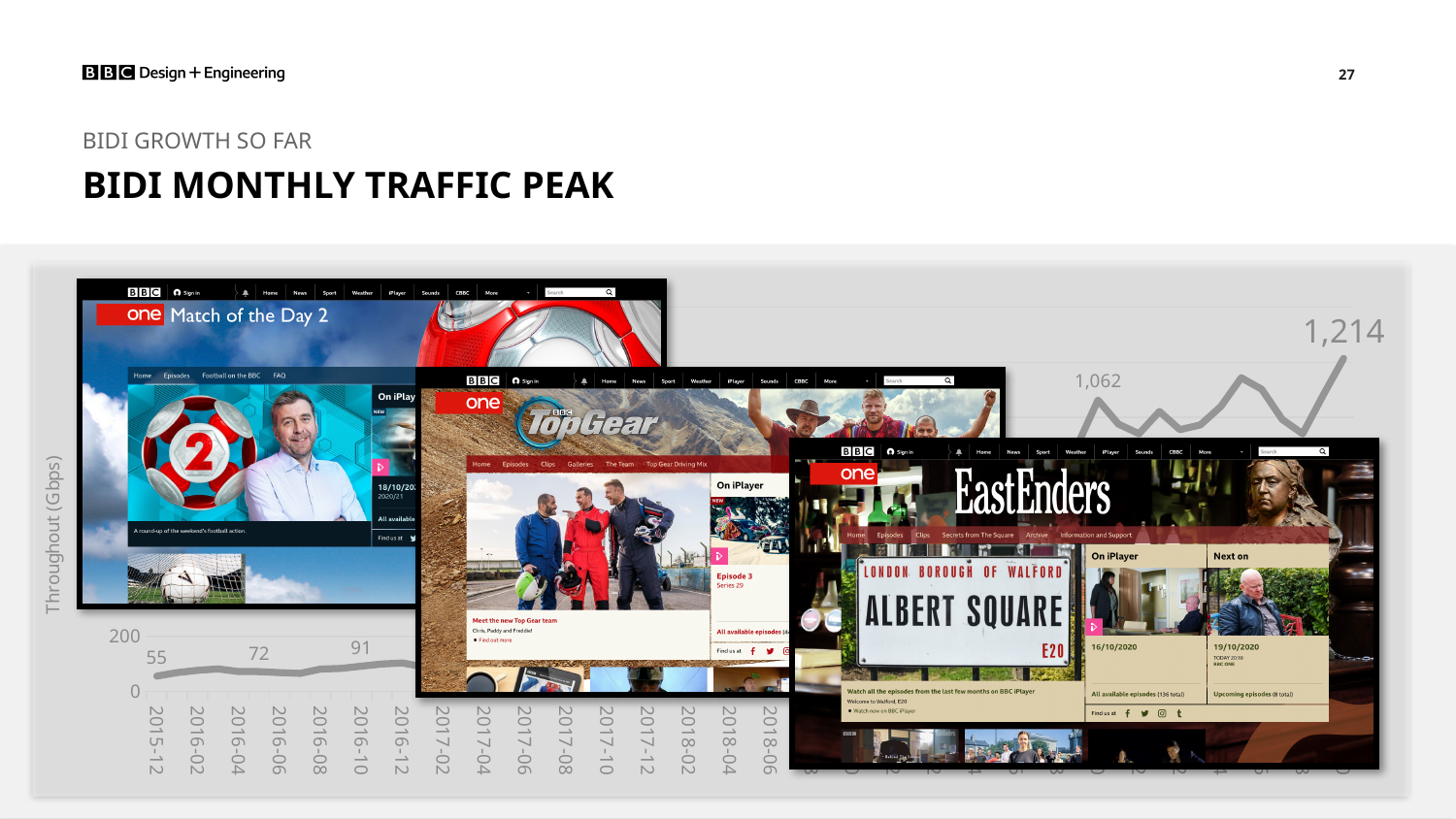
Which labelled value is larger, 72 or 91? 91 What is the value of the last data point on the chart? 1,214 What is the title of the chart on the slide? BIDI MONTHLY TRAFFIC PEAK What is the highest value labelled on the chart? 1,214 Is the value at 2015-12 greater or less than 200? less What kind of chart is shown on the slide? line chart Do the values on the chart generally rise or fall over time along the x axis? rise What is the difference between the labelled values 91 and 55 on the chart? 36 What is the value of the first data point on the chart, at 2015-12? 55 What is the label on the vertical axis of the chart? Throughput (Gbps) What is the lowest value labelled on the chart? 55 What is the difference between the labelled values 1,214 and 1,062 on the chart? 152